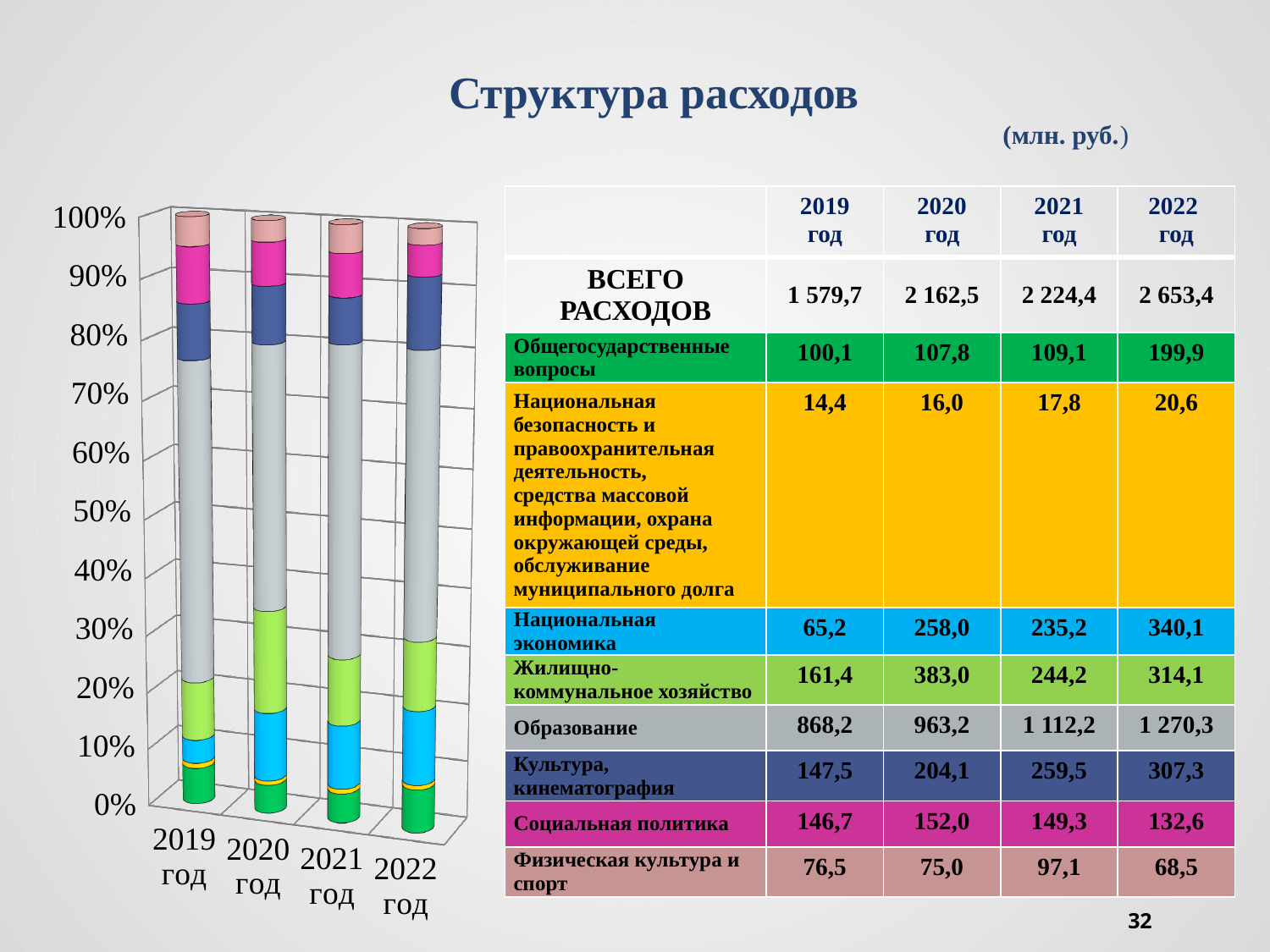
Do the values for Образование rise or fall from 2019 год to 2022 год? rise Which year has the highest total expenditure (ВСЕГО РАСХОДОВ)? 2022 год What kind of chart is shown on the left of the slide? stacked bar chart How many years (categories) are shown on the x axis of the chart? 4 Which year has the larger value for Жилищно-коммунальное хозяйство, 2020 год or 2021 год? 2020 год What is the difference between the Национальная экономика values for 2022 год and 2019 год? 274,9 How many expenditure categories are stacked in each bar (excluding the total row)? 8 In which year is the value for Физическая культура и спорт the lowest? 2022 год What is the value of ВСЕГО РАСХОДОВ for 2019 год? 1 579,7 What is the title of the slide's chart and table? Структура расходов What is the value for Образование in 2022 год? 1 270,3 In the 2019 год bar, is the share of the grey Образование segment greater or less than 50%? greater